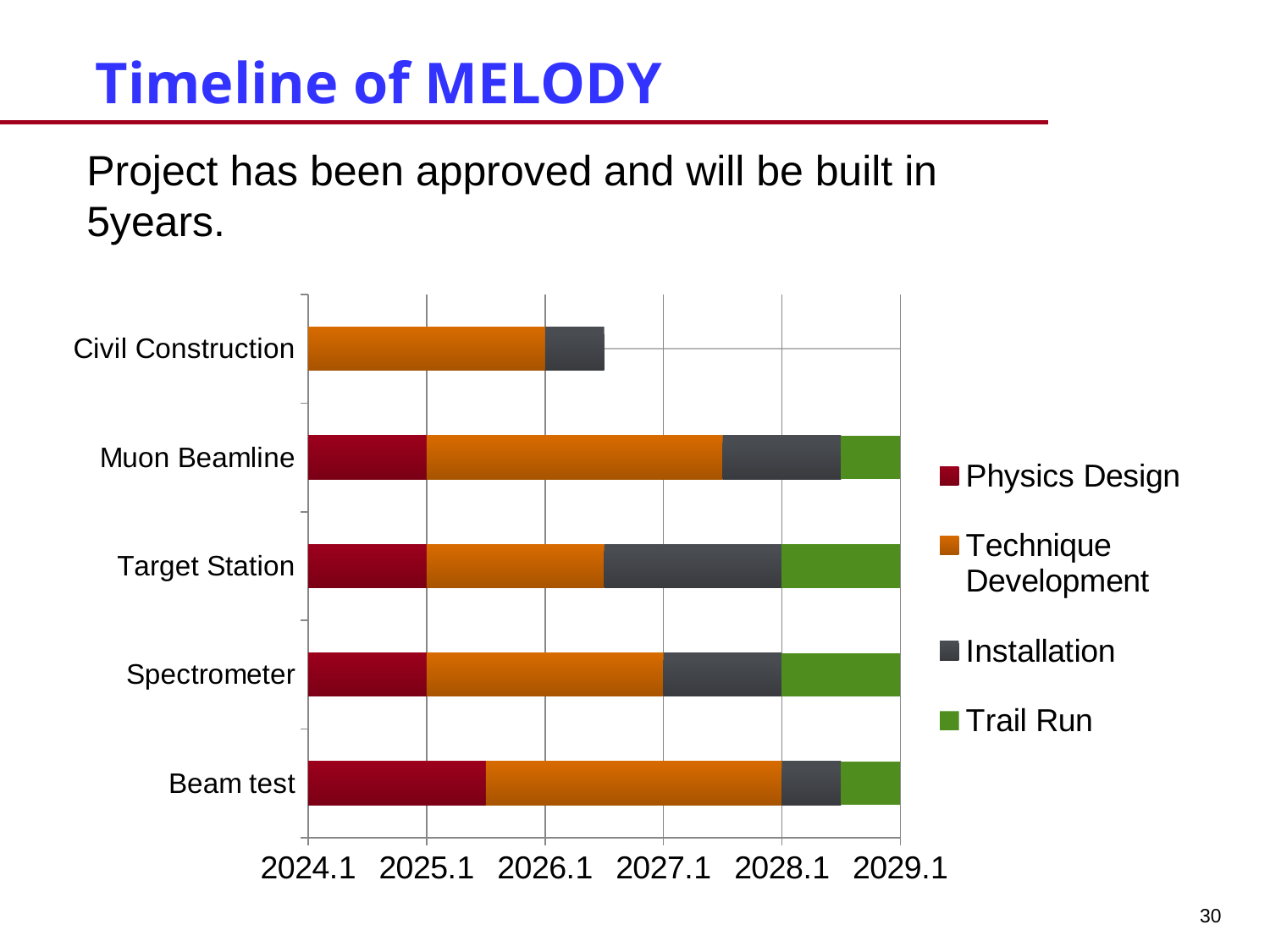
How many categories (work packages) are listed on the vertical axis of the chart? 5 At which axis tick does the Technique Development segment for Civil Construction end? 2026.1 What kind of chart is shown on the slide? Stacked bar chart Which category has no Physics Design segment? Civil Construction Which colour represents Trail Run in the legend? Green Does the Civil Construction bar end before or after 2027.1? before Which category has the longest Installation segment? Target Station Which category has the longest Physics Design segment? Beam test Does the Physics Design segment for Beam test end before or after 2025.1? after At which axis tick does the Physics Design segment for Muon Beamline end? 2025.1 Which category's bar ends earliest on the time axis? Civil Construction How many series does the chart legend list? 4